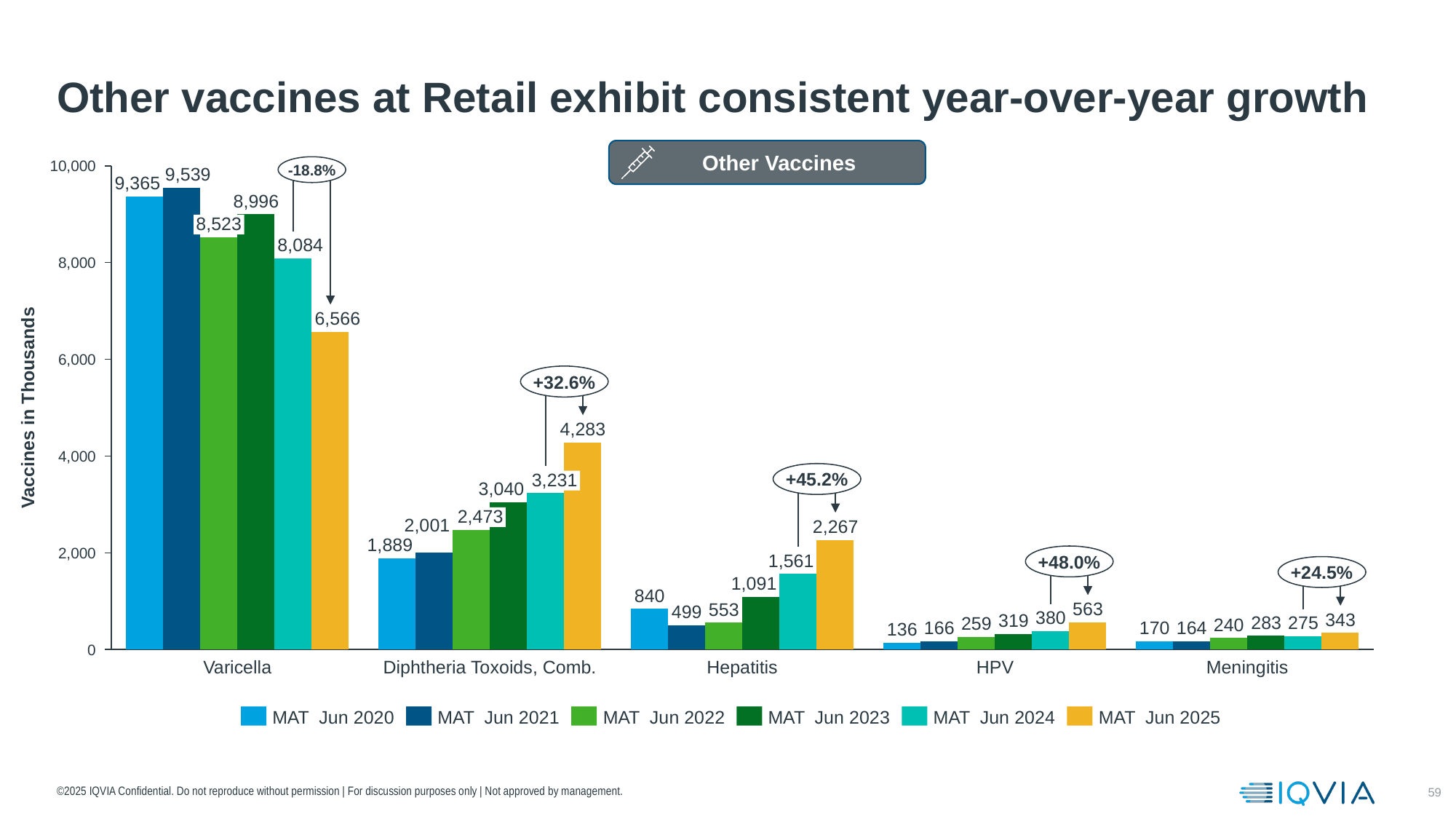
What is the value for HPV in MAT Jun 2023? 319 What is the value for Varicella in MAT Jun 2025? 6,566 What is the difference between the MAT Jun 2024 and MAT Jun 2025 values for Diphtheria Toxoids, Comb.? 1,052 What percentage change is annotated above the Hepatitis bars? +45.2% Which is larger for Meningitis: the MAT Jun 2023 value or the MAT Jun 2024 value? MAT Jun 2023 Which vaccine category has the lowest value in MAT Jun 2020? HPV How many vaccine categories are shown on the x axis? 5 What kind of chart is shown on the slide? Bar chart Which vaccine category has the highest value in MAT Jun 2025? Varicella How many series does the legend list? 6 Is the value for Varicella in MAT Jun 2021 greater or less than 8,000? greater What is the value for Hepatitis in MAT Jun 2020? 840